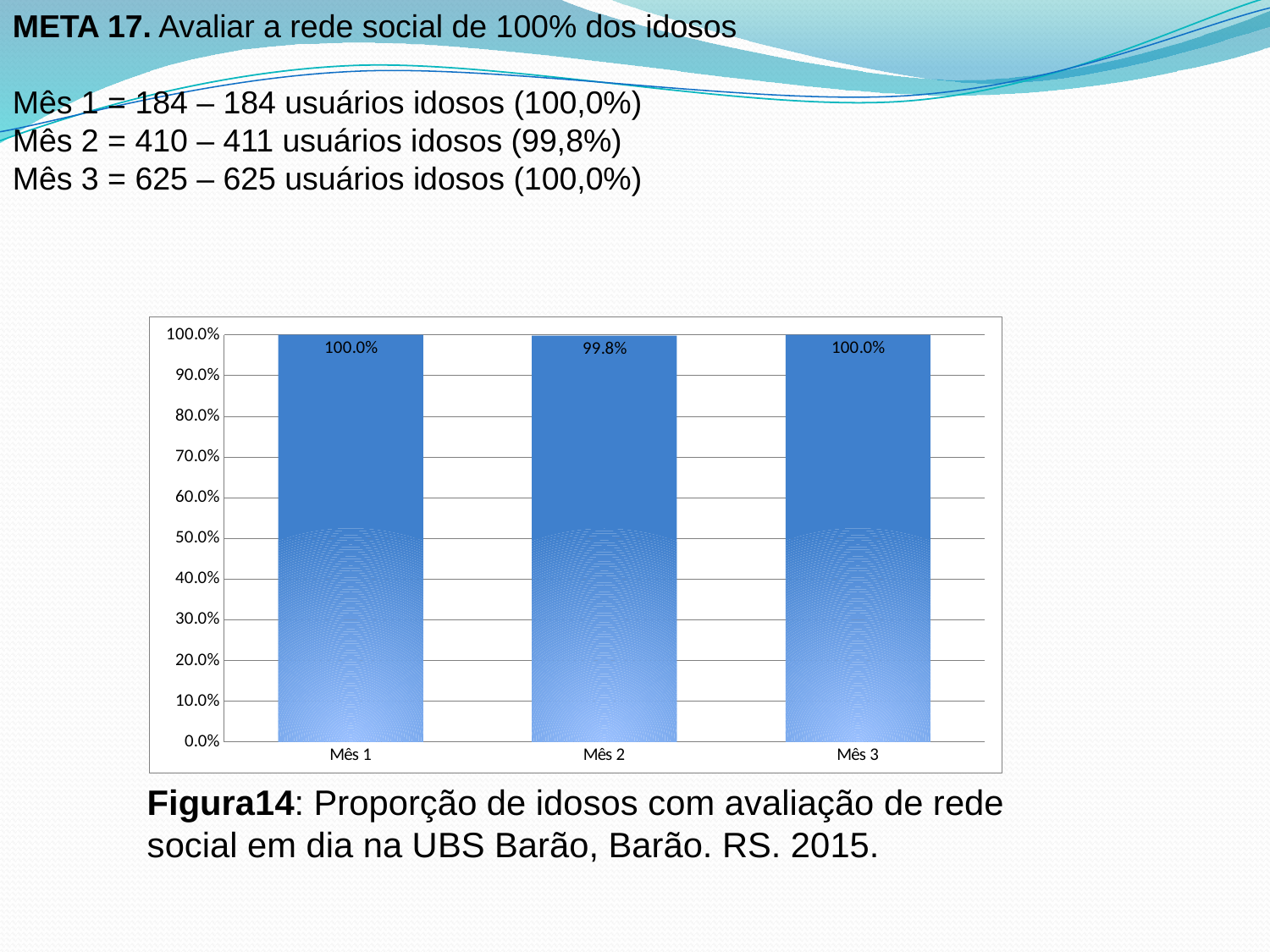
What figure number is given in the caption below the chart? Figura14 What is the highest value shown on the vertical axis of the chart? 100.0% What is the difference between the values for Mês 1 and Mês 2? 0.2% What kind of chart is shown on the slide? bar chart Which is larger, the value for Mês 3 or the value for Mês 2? Mês 3 Which month has the lowest value in the chart? Mês 2 Is the value for Mês 2 greater or less than 90.0%? greater What is the value shown for Mês 1? 100.0% How many months (categories) are plotted in the chart? 3 What is the value shown for Mês 2? 99.8% What is the value shown for Mês 3? 100.0%